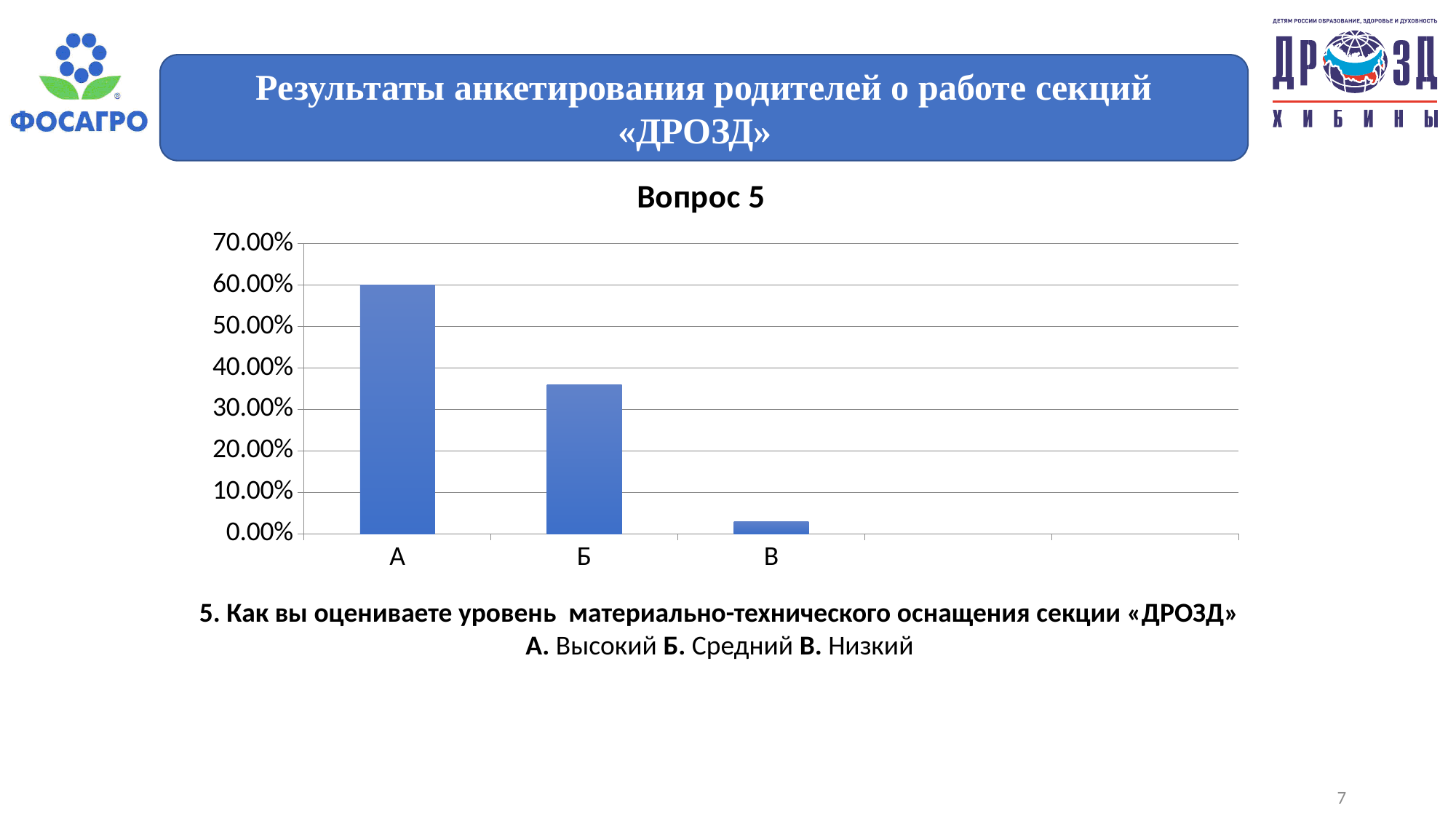
What is the title of the chart? Вопрос 5 Which category has the lowest value? В Is the value for Б greater or less than 30.00%? greater How many categories are plotted on the x axis? 3 What kind of chart is shown on the slide? bar chart What is the highest value shown on the y axis? 70.00% Which category has the highest value? А What is the value for category А? 60.00% Is the value for Б greater or less than 40.00%? less Do the values rise or fall from А to В along the x axis? fall Which is larger, the value for А or the value for Б? А Is the value for В greater or less than 10.00%? less